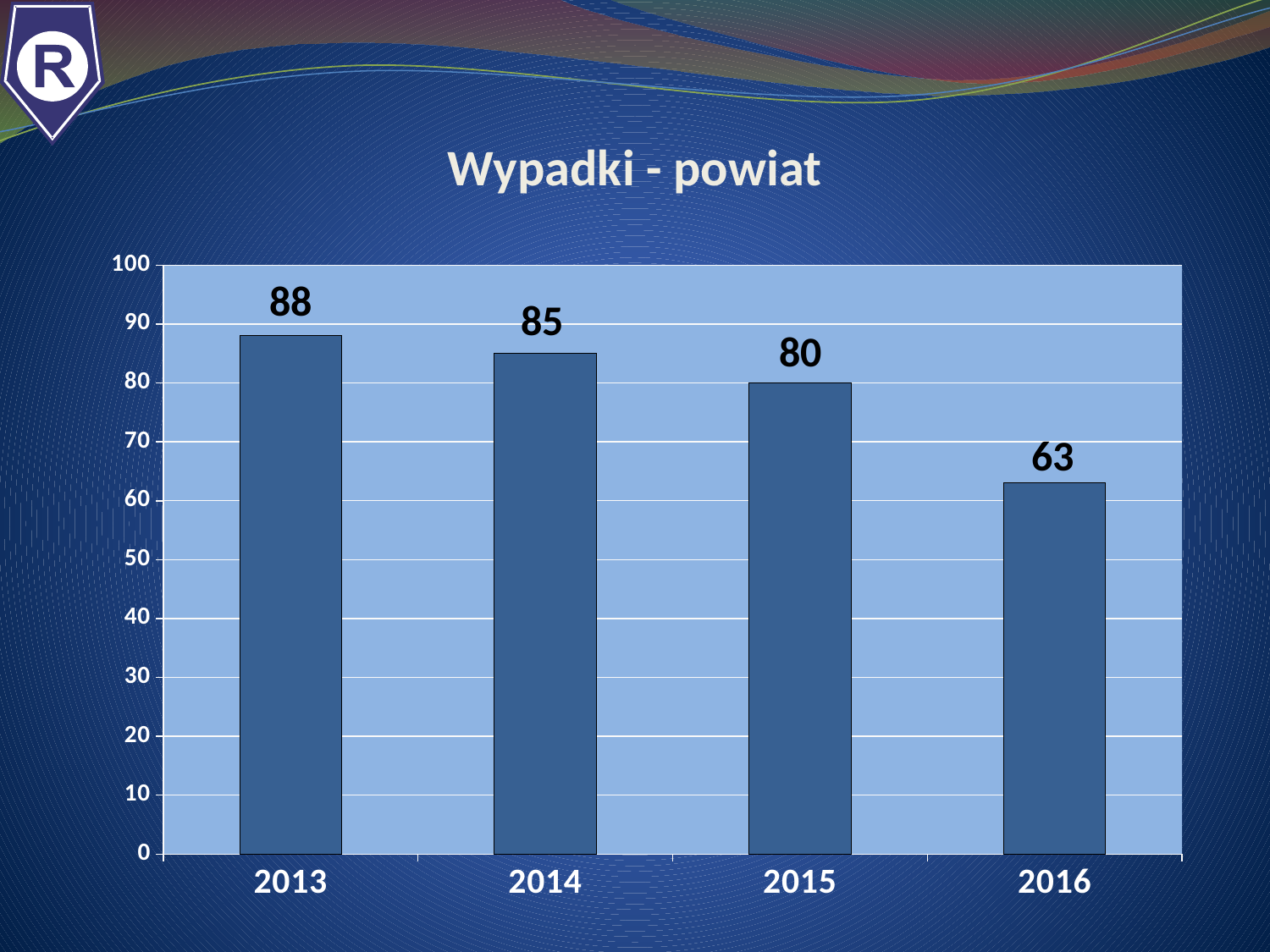
What is the value for 2013? 88 How many years are shown on the x axis? 4 Do the values rise or fall from 2013 to 2016? fall Is the value for 2016 greater or less than 70? less Which year has the lowest value? 2016 Which year has the highest value? 2013 What is the difference between the values for 2014 and 2015? 5 Which is larger, the value for 2014 or the value for 2016? 2014 What is the value for 2016? 63 What is the value for 2015? 80 What kind of chart is shown on the slide? bar chart What is the difference between the values for 2013 and 2016? 25